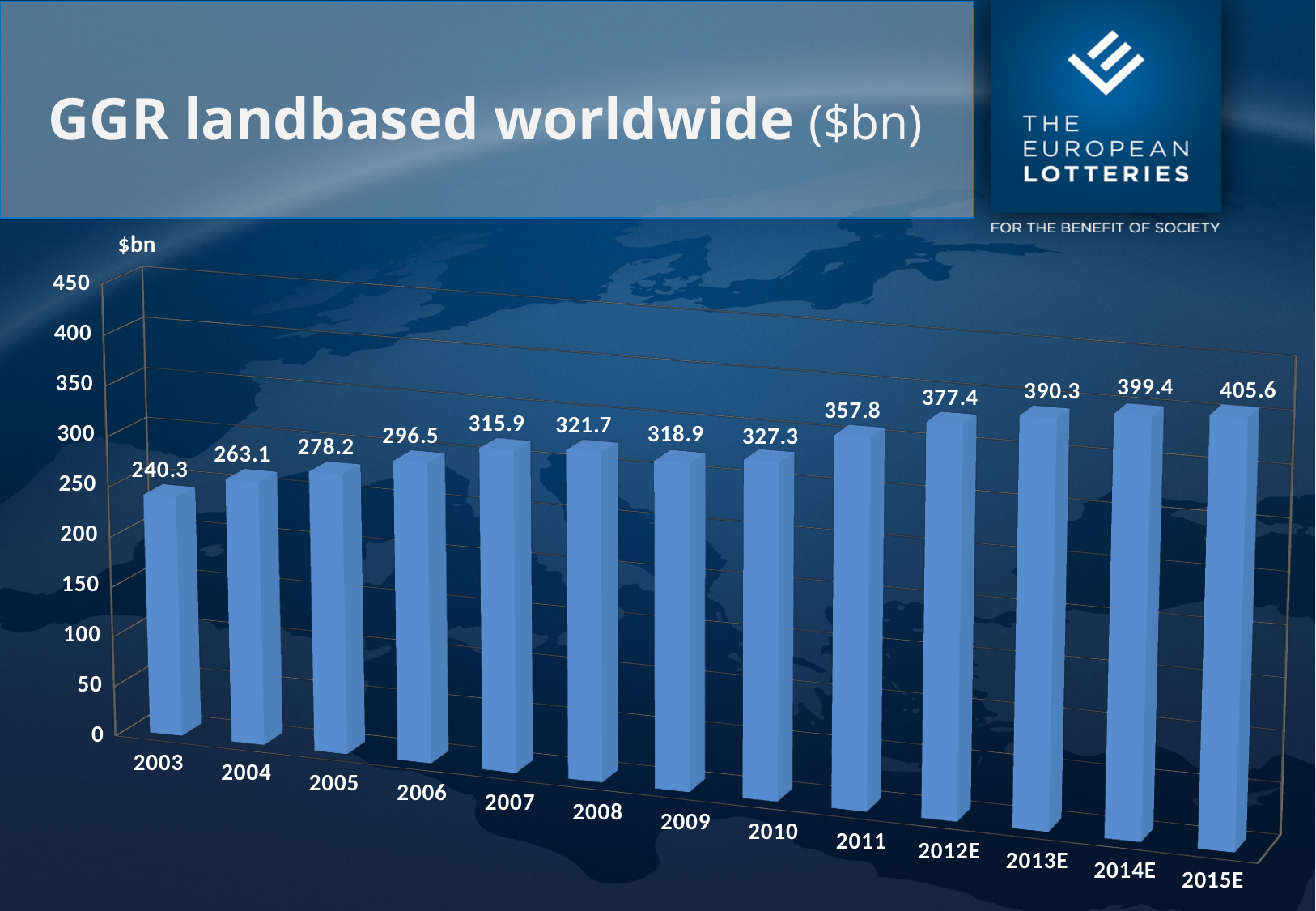
What is the difference between the values for 2015E and 2003? 165.3 Which year has the lowest value? 2003 Which year has the highest value? 2015E What kind of chart is shown on the slide? Bar chart How many years are shown on the x axis? 13 What is the value shown for 2015E? 405.6 Which is larger, the value for 2008 or the value for 2009? 2008 What unit is shown on the y axis of the chart? $bn What is the value shown for 2011? 357.8 What is the GGR landbased worldwide value for 2003? 240.3 What is the difference between the values for 2008 and 2009? 2.8 Do the values generally rise or fall from 2003 to 2015E? Rise